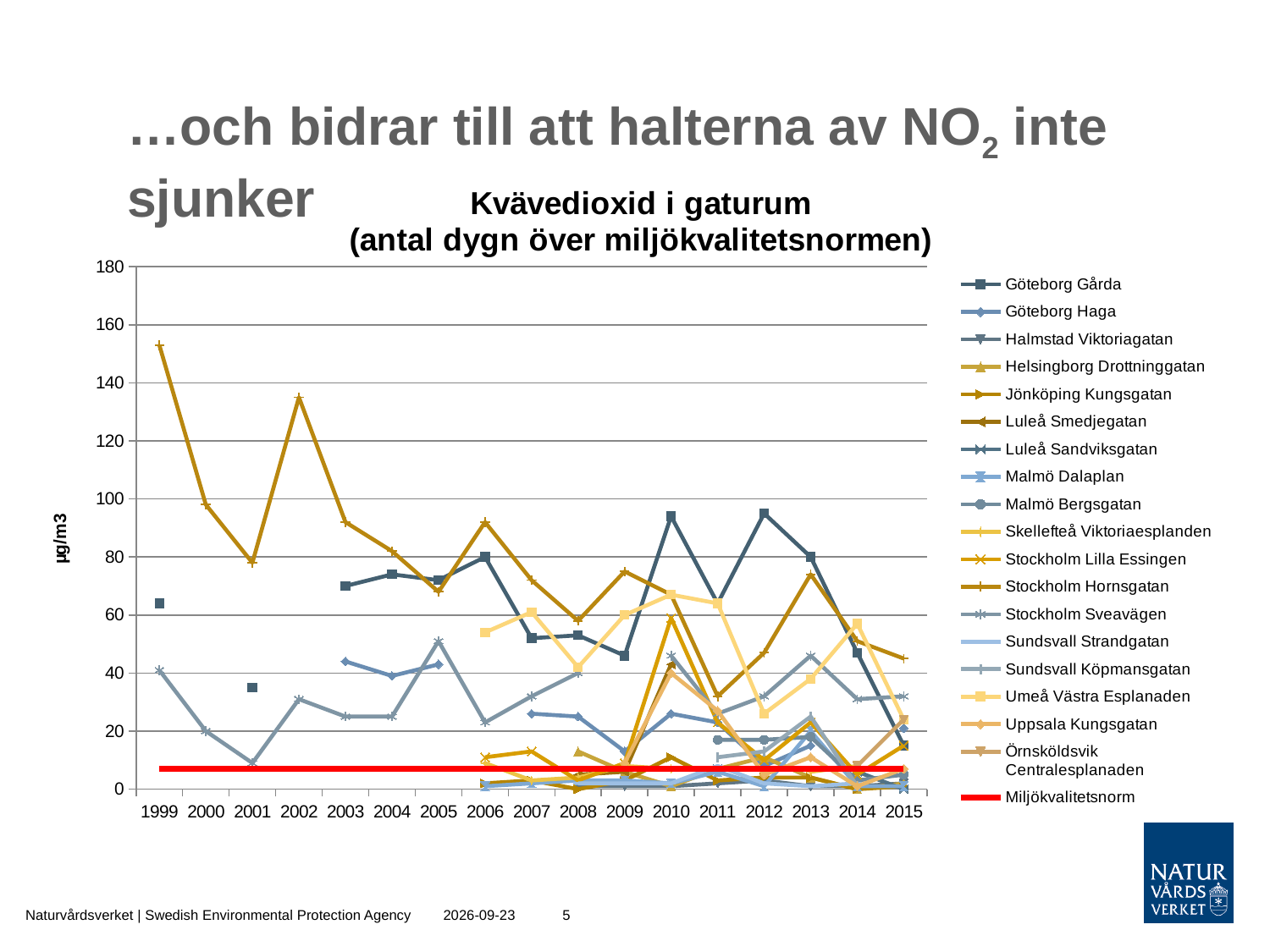
Which series has the highest value in 1999? Stockholm Hornsgatan For Göteborg Gårda, which year has the larger value, 2014 or 2015? 2014 What kind of chart is shown on the slide? line chart Is the value for Stockholm Hornsgatan in 1999 greater or less than 140? greater Is the Miljökvalitetsnorm line greater or less than 20? less Does the Stockholm Hornsgatan series overall rise or fall from 1999 to 2015? fall Is the value for Stockholm Hornsgatan in 2002 greater or less than 120? greater What is the title of the chart? Kvävedioxid i gaturum (antal dygn över miljökvalitetsnormen) How many years are shown along the x axis of the chart? 17 How many entries does the chart's legend list? 19 What is the label on the y axis of the chart? µg/m3